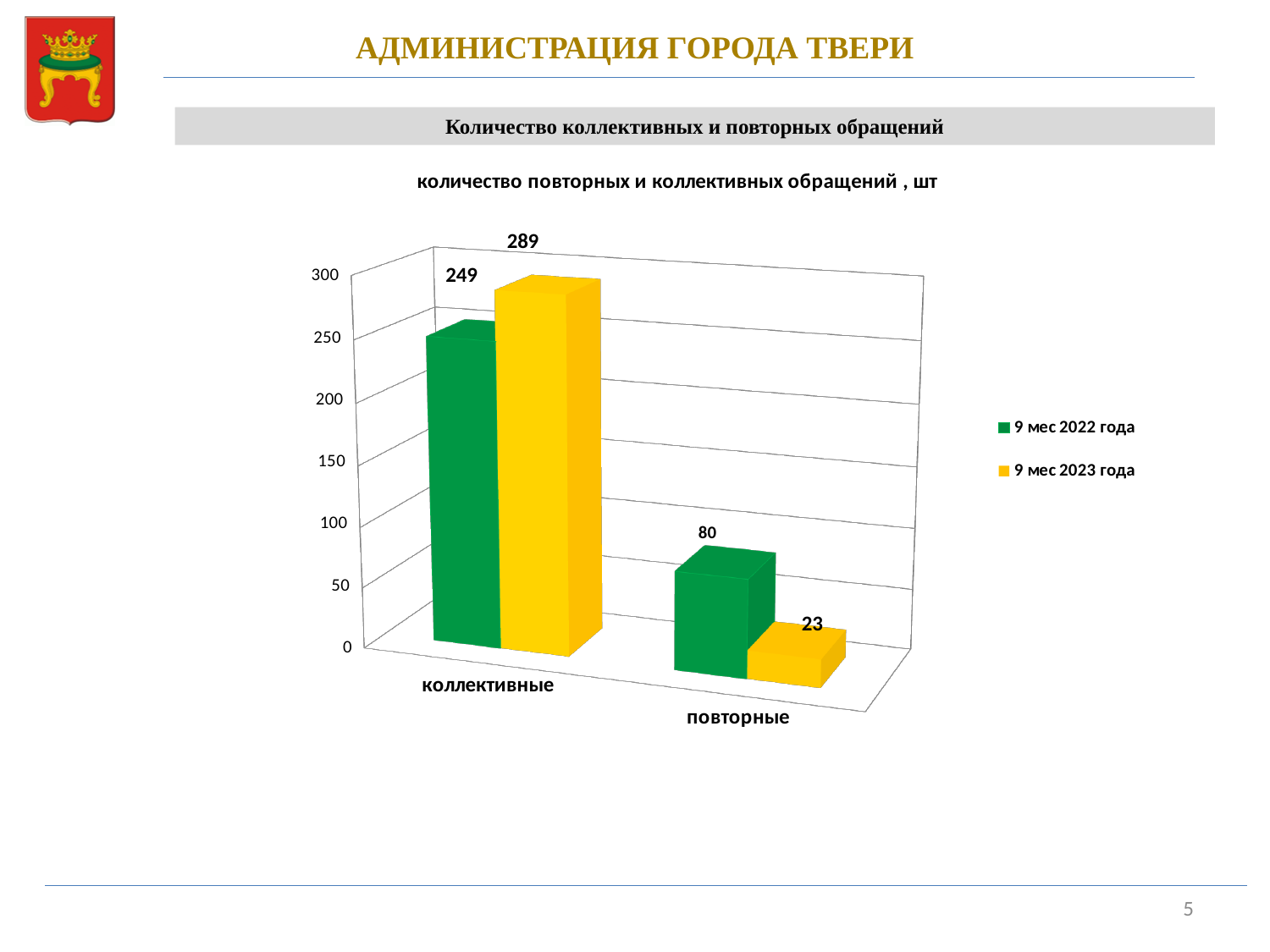
What is the value for коллективные in 9 мес 2023 года? 289 How many categories are shown on the x axis? 2 Which category has the lowest value in 9 мес 2022 года? повторные What is the value for повторные in 9 мес 2023 года? 23 What kind of chart is shown on the slide? bar chart Which is larger for повторные: 9 мес 2022 года or 9 мес 2023 года? 9 мес 2022 года What is the difference between the 9 мес 2023 года and 9 мес 2022 года values for коллективные? 40 What is the difference between the 9 мес 2022 года and 9 мес 2023 года values for повторные? 57 What is the value for коллективные in 9 мес 2022 года? 249 What is the value for повторные in 9 мес 2022 года? 80 How many series does the legend list? 2 Which category has the highest value in 9 мес 2023 года? коллективные